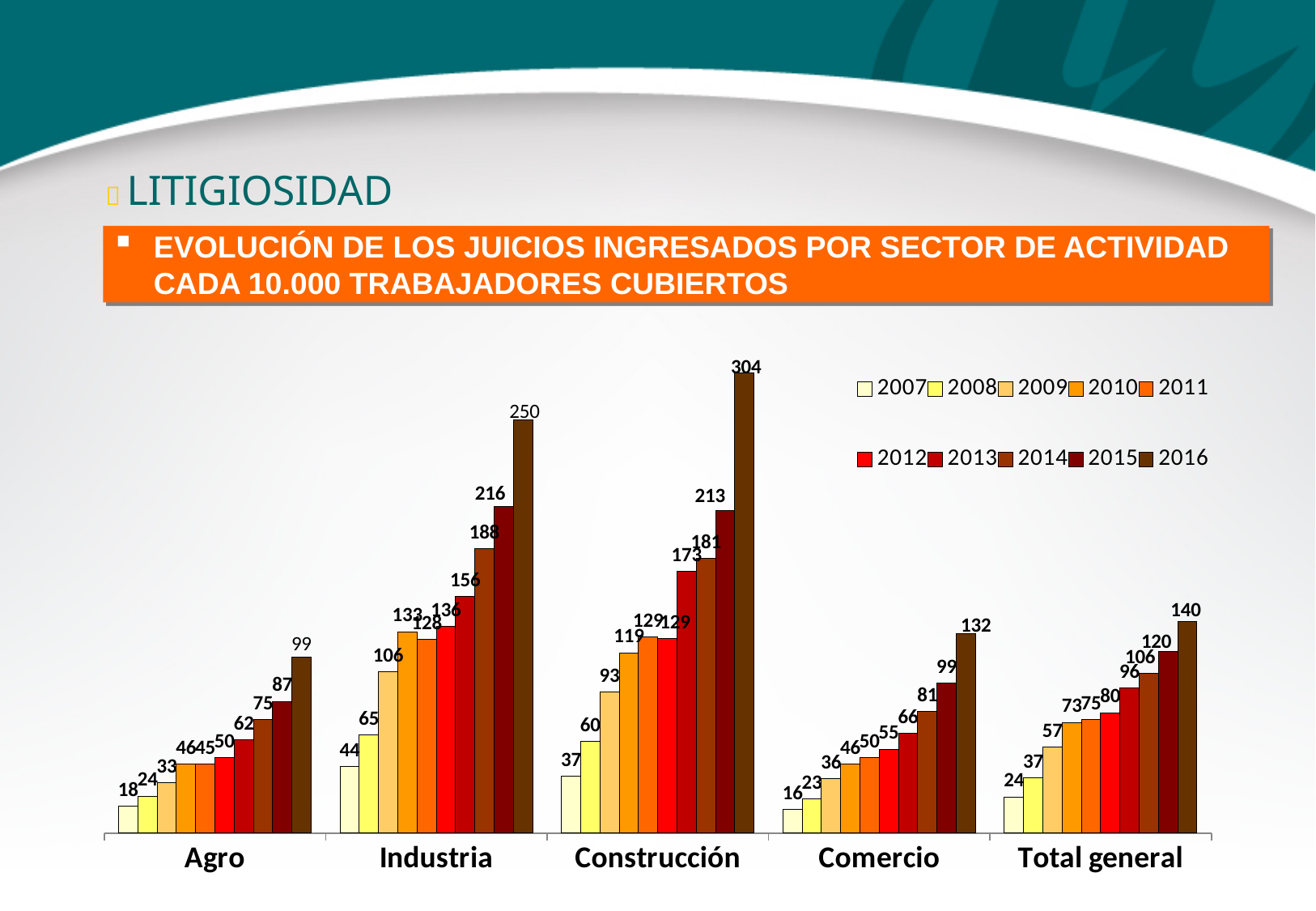
Which sector has the highest value in 2016? Construcción What is the value for Agro in 2007? 18 What is the value for Construcción in 2016? 304 Which sector has the lowest value in 2007? Comercio How many series does the legend list? 10 What is the value for Comercio in 2015? 99 What is the value for Industria in 2016? 250 What is the value for Total general in 2016? 140 Which is larger, the 2016 value for Agro or the 2016 value for Comercio? Comercio How many sector categories are shown on the x axis? 5 What kind of chart is shown on the slide? Bar chart What is the difference between the 2016 and 2007 values for Industria? 206